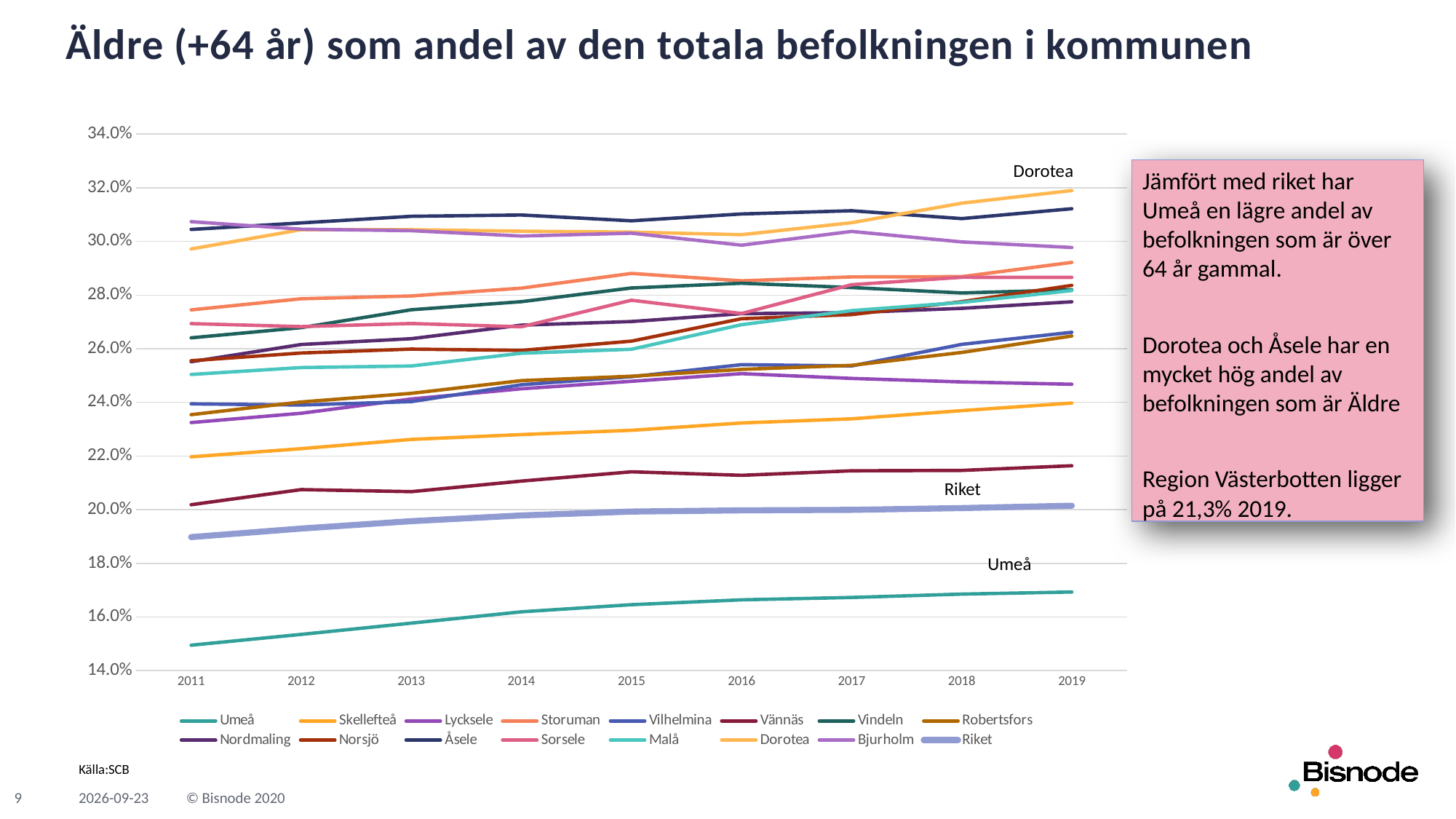
In 2019, which is larger: the value for Riket or the value for Umeå? Riket Which series has the highest value in 2019? Dorotea What kind of chart is shown on the slide? Line chart Does the Umeå line rise or fall from 2011 to 2019? Rises What is the title of the chart? Äldre (+64 år) som andel av den totala befolkningen i kommunen Is the value for Dorotea in 2019 greater or less than 30.0%? greater Is the value for Riket in 2011 greater or less than 20.0%? less Which series has the lowest values across the whole chart? Umeå Is the value for Umeå in 2011 greater or less than 16.0%? less How many series does the legend list? 16 How many years are shown along the x axis? 9